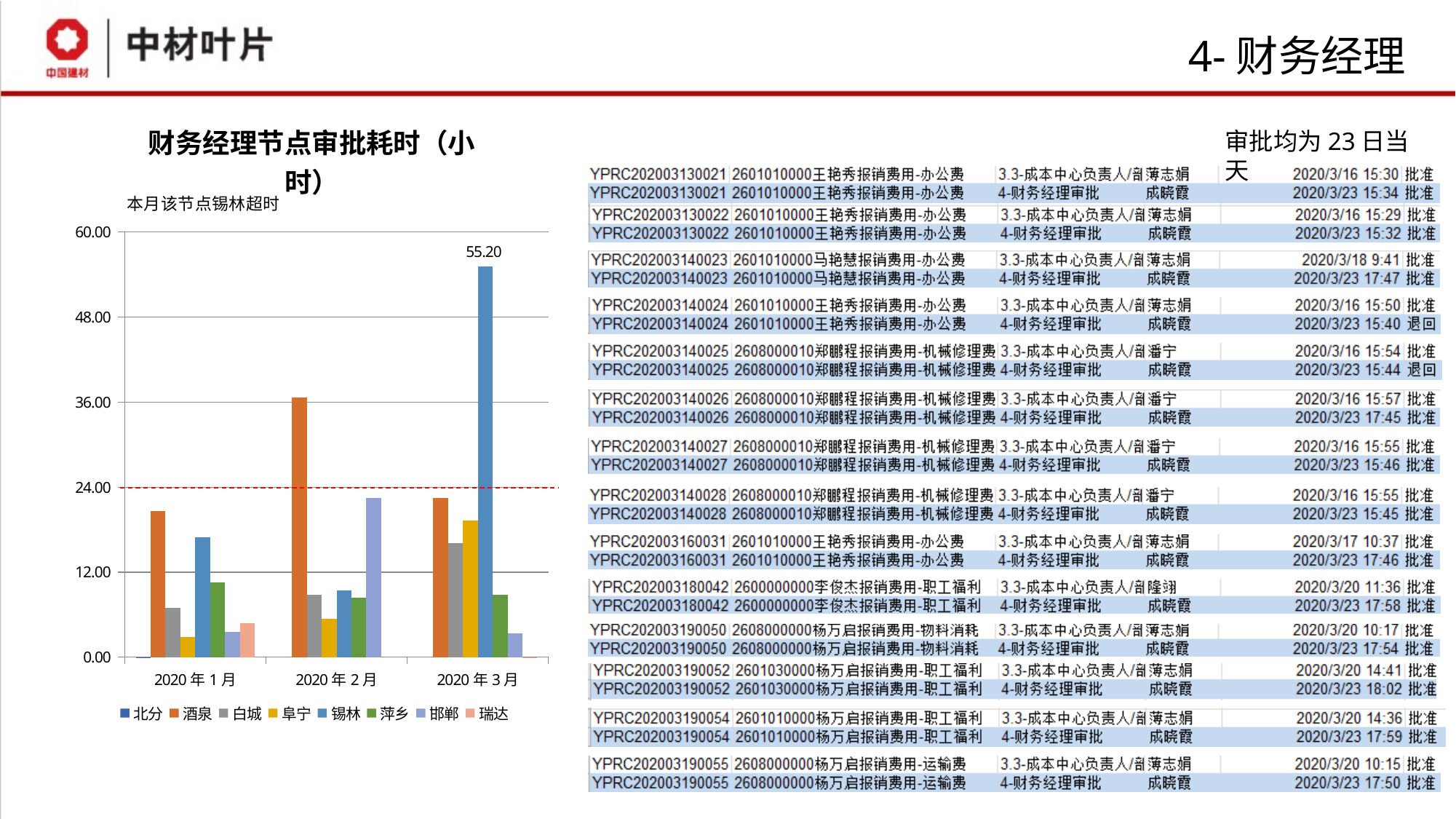
What is the title of the chart? 财务经理节点审批耗时（小时） What kind of chart is shown on the slide? bar chart How many month categories are shown on the x axis? 3 Which series has the highest value in 2020年3月? 锡林 In 2020年1月, which is larger, the value for 酒泉 or the value for 白城? 酒泉 At what value on the y axis is the red dashed reference line drawn? 24.00 Is the value for 萍乡 in 2020年1月 greater or less than 12.00? less Is the value for 酒泉 in 2020年2月 greater or less than 24.00? greater Is the value for 锡林 in 2020年3月 greater or less than 48.00? greater Which series has the highest value in 2020年2月? 酒泉 How many series does the chart legend list? 8 What is the value for 锡林 in 2020年3月? 55.20